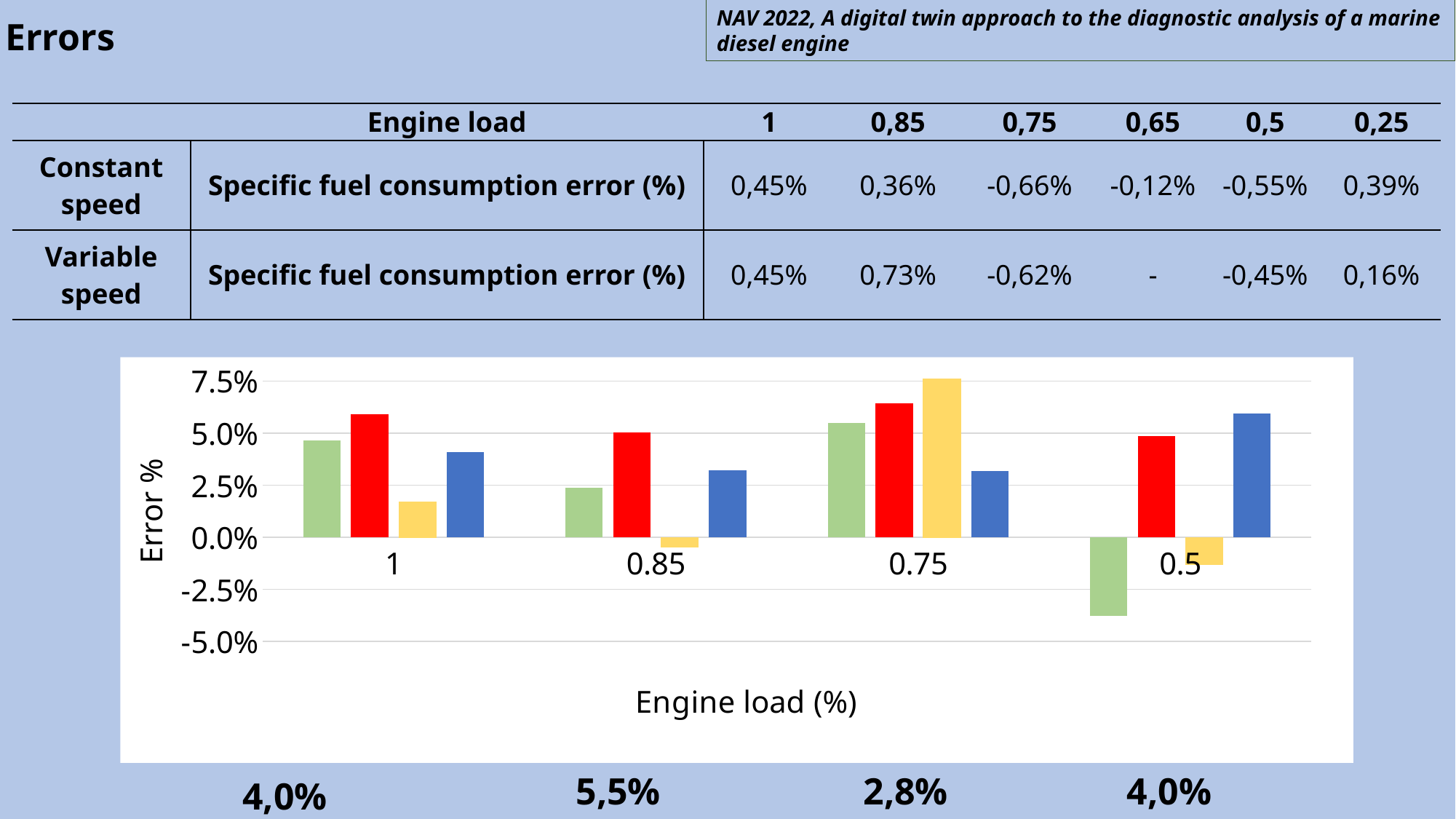
How many engine load categories are shown on the x axis of the chart? 4 At which engine load does the tallest bar in the chart appear? 0.75 What is the title of the horizontal axis of the chart? Engine load (%) How many bars are plotted for each engine load category in the chart? 4 Is the value of the green bar at engine load 1 greater or less than 2.5%? greater Is the value of the green bar at engine load 0.5 greater or less than -2.5%? less What kind of chart is shown on the slide? bar chart What is the title of the vertical axis of the chart? Error % Is the value of the yellow bar at engine load 0.75 greater or less than 5.0%? greater Which is larger: the red bar at engine load 1 or the red bar at engine load 0.85? the red bar at engine load 1